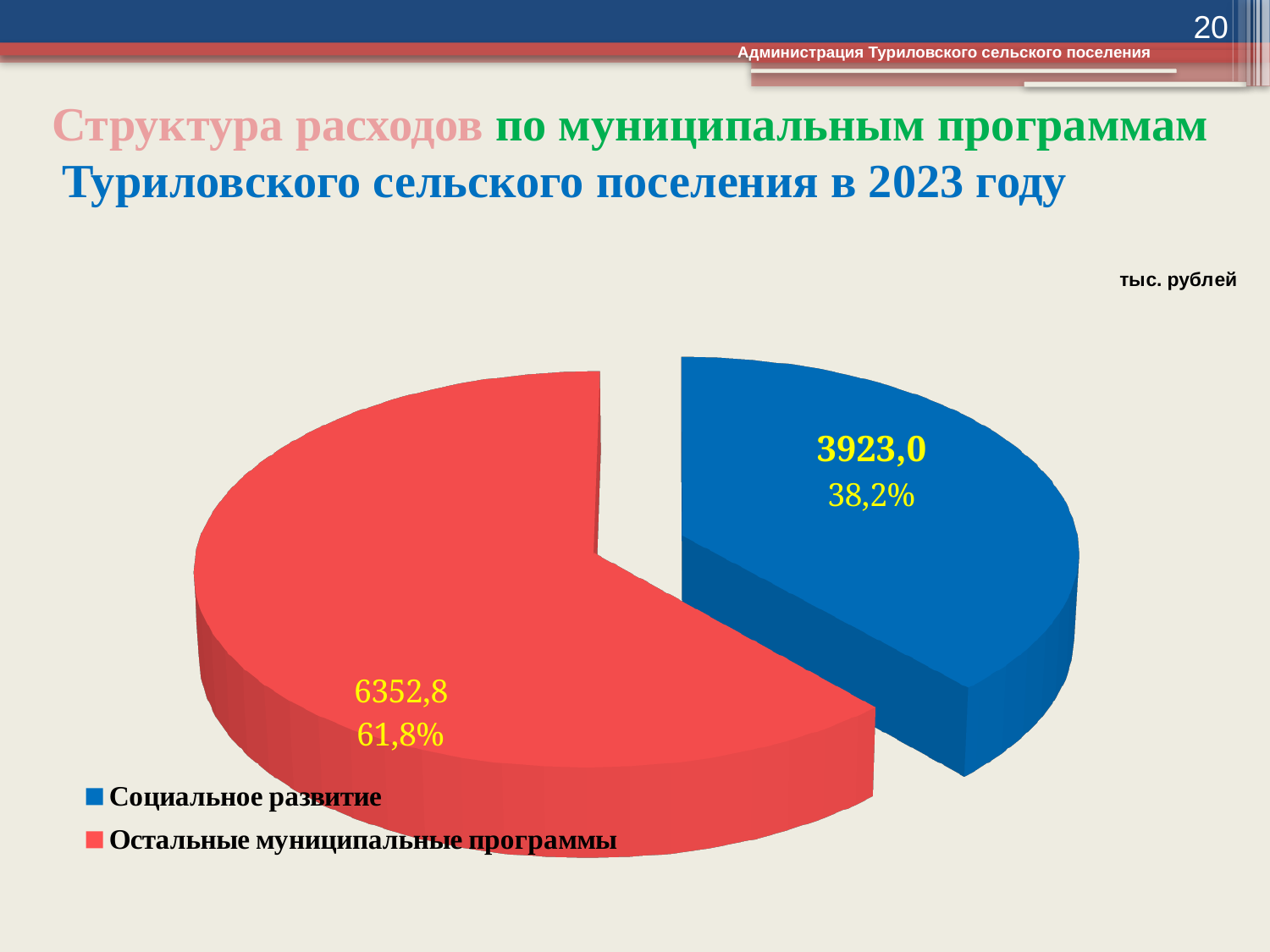
Which is larger: Социальное развитие or Остальные муниципальные программы? Остальные муниципальные программы What kind of chart is shown on the slide? pie chart What is the difference between the values for Остальные муниципальные программы and Социальное развитие? 2429,8 What share of the pie does Остальные муниципальные программы take? 61,8% Which category has the largest slice? Остальные муниципальные программы What is the value for Социальное развитие? 3923,0 What unit is stated for the values on the chart? тыс. рублей What share of the pie does Социальное развитие take? 38,2% What is the value for Остальные муниципальные программы? 6352,8 Which category has the smallest slice? Социальное развитие How many slices does the pie chart have? 2 What colour is the slice for Социальное развитие? blue